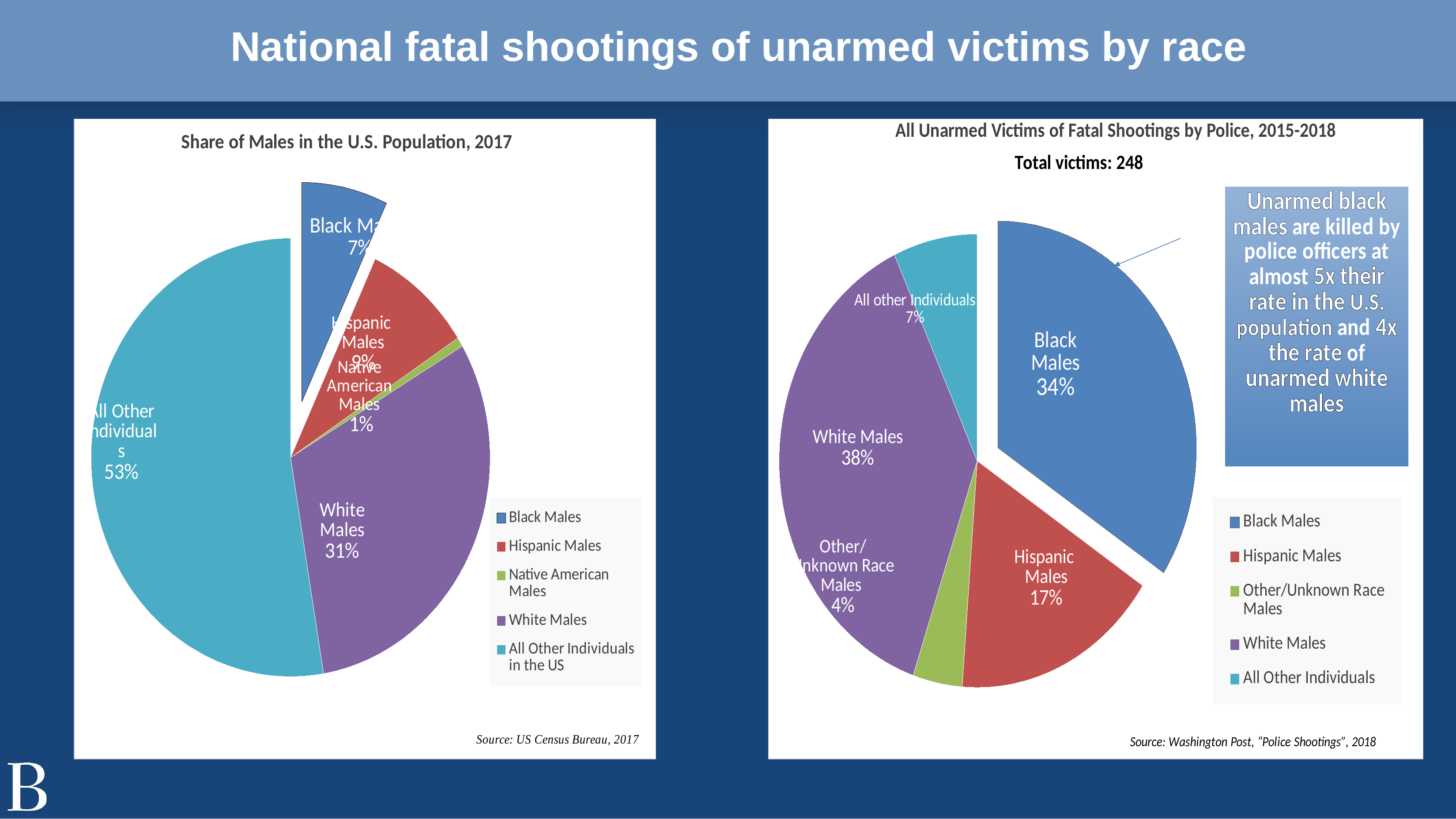
In the 'Share of Males in the U.S. Population, 2017' chart, what share is labelled for Black Males? 7% In the 'Share of Males in the U.S. Population, 2017' chart, how many entries does the legend list? 5 In the 'All Unarmed Victims of Fatal Shootings by Police, 2015-2018' chart, what share is labelled for Hispanic Males? 17% In the 'All Unarmed Victims of Fatal Shootings by Police, 2015-2018' chart, which category has the smallest slice? Other/Unknown Race Males In the 'Share of Males in the U.S. Population, 2017' chart, which category has the largest slice? All Other Individuals Which is larger: the Black Males share in the 'Share of Males in the U.S. Population, 2017' chart or the Black Males share in the 'All Unarmed Victims of Fatal Shootings by Police, 2015-2018' chart? All Unarmed Victims of Fatal Shootings by Police, 2015-2018 In the 'All Unarmed Victims of Fatal Shootings by Police, 2015-2018' chart, what share is labelled for Black Males? 34% What kind of chart is the 'Share of Males in the U.S. Population, 2017' chart on the left? Pie chart In the 'All Unarmed Victims of Fatal Shootings by Police, 2015-2018' chart, what is the total number of victims stated? 248 In the 'Share of Males in the U.S. Population, 2017' chart, what share is labelled for White Males? 31% In the 'All Unarmed Victims of Fatal Shootings by Police, 2015-2018' chart, what is the difference between the White Males share and the Black Males share? 4% In the 'Share of Males in the U.S. Population, 2017' chart, what share is labelled for Native American Males? 1%